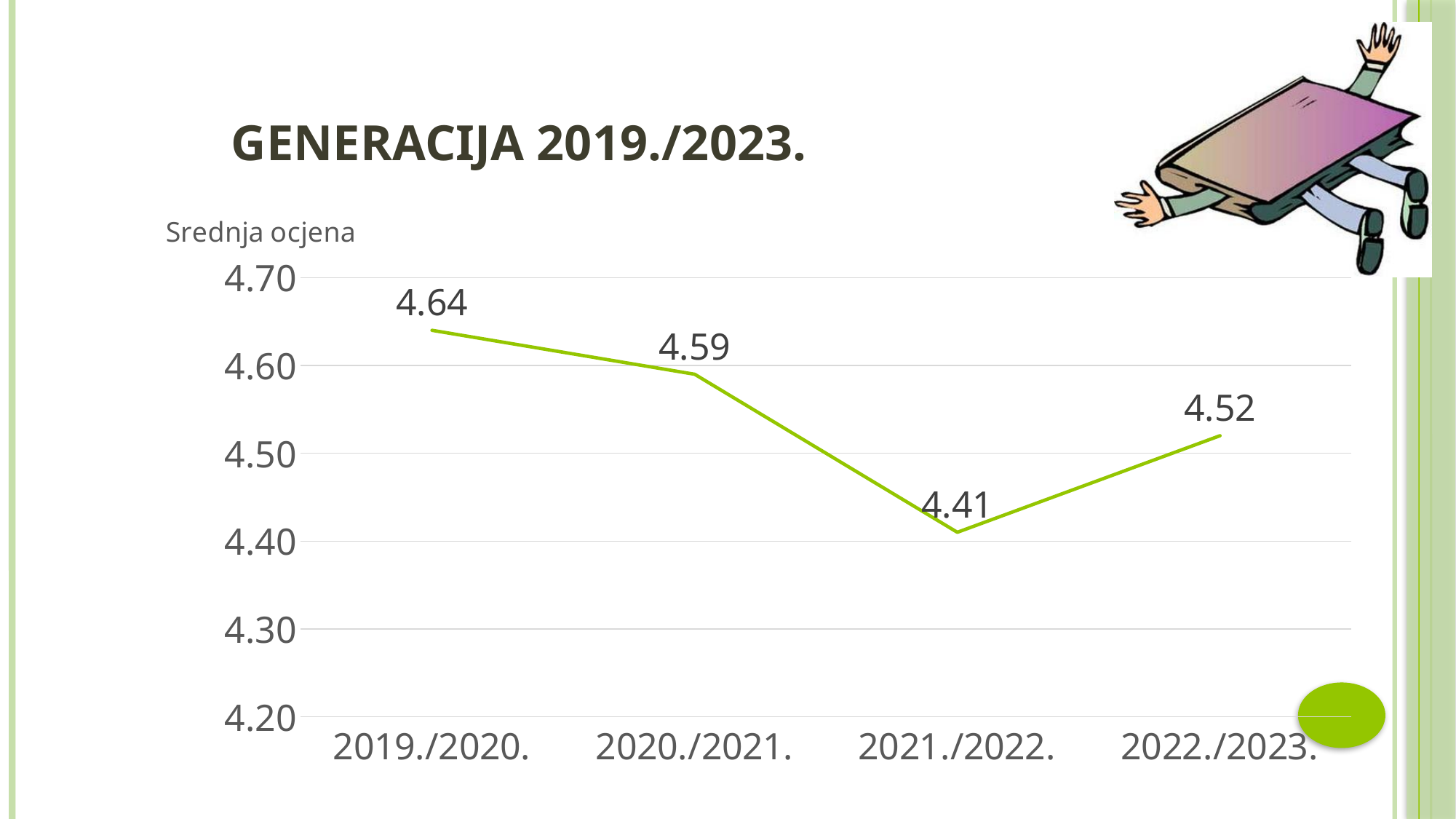
What is the average grade for 2022./2023.? 4.52 What kind of chart is shown on the slide? line chart What is the title of the chart? Srednja ocjena Which school year has the highest average grade? 2019./2020. What is the difference between the average grade in 2022./2023. and 2021./2022.? 0.11 What is the difference between the average grade in 2019./2020. and 2021./2022.? 0.23 What is the average grade for 2021./2022.? 4.41 Is the value for 2021./2022. greater or less than 4.50? less What is the average grade (Srednja ocjena) for 2019./2020.? 4.64 How many school years are plotted on the chart? 4 Which is larger, the average grade for 2020./2021. or for 2022./2023.? 2020./2021. Which school year has the lowest average grade? 2021./2022.